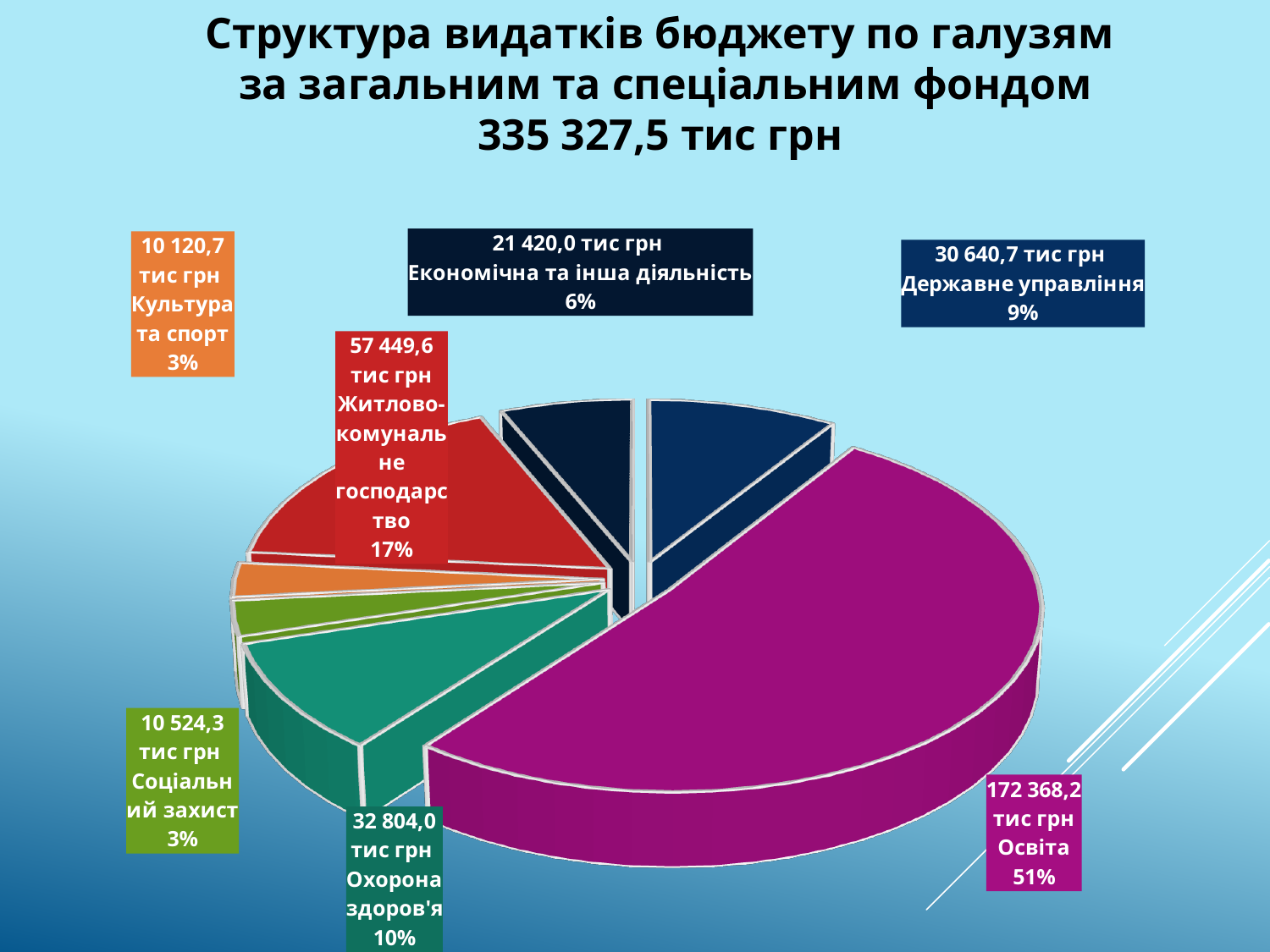
What is the total budget expenditure stated in the chart title? 335 327,5 тис грн How many categories are shown in the pie chart? 7 What is the value for Житлово-комунальне господарство? 57 449,6 тис грн What is the difference between the values for Соціальний захист and Культура та спорт? 403,6 тис грн What share of the pie does Освіта represent? 51% What percentage is shown for Охорона здоров'я? 10% Which category has the smallest value? Культура та спорт Which is larger, Державне управління or Економічна та інша діяльність? Державне управління What percentage is shown for Державне управління? 9% What is the value for Освіта? 172 368,2 тис грн What kind of chart is shown on the slide? Pie chart Which category has the largest share of the pie? Освіта